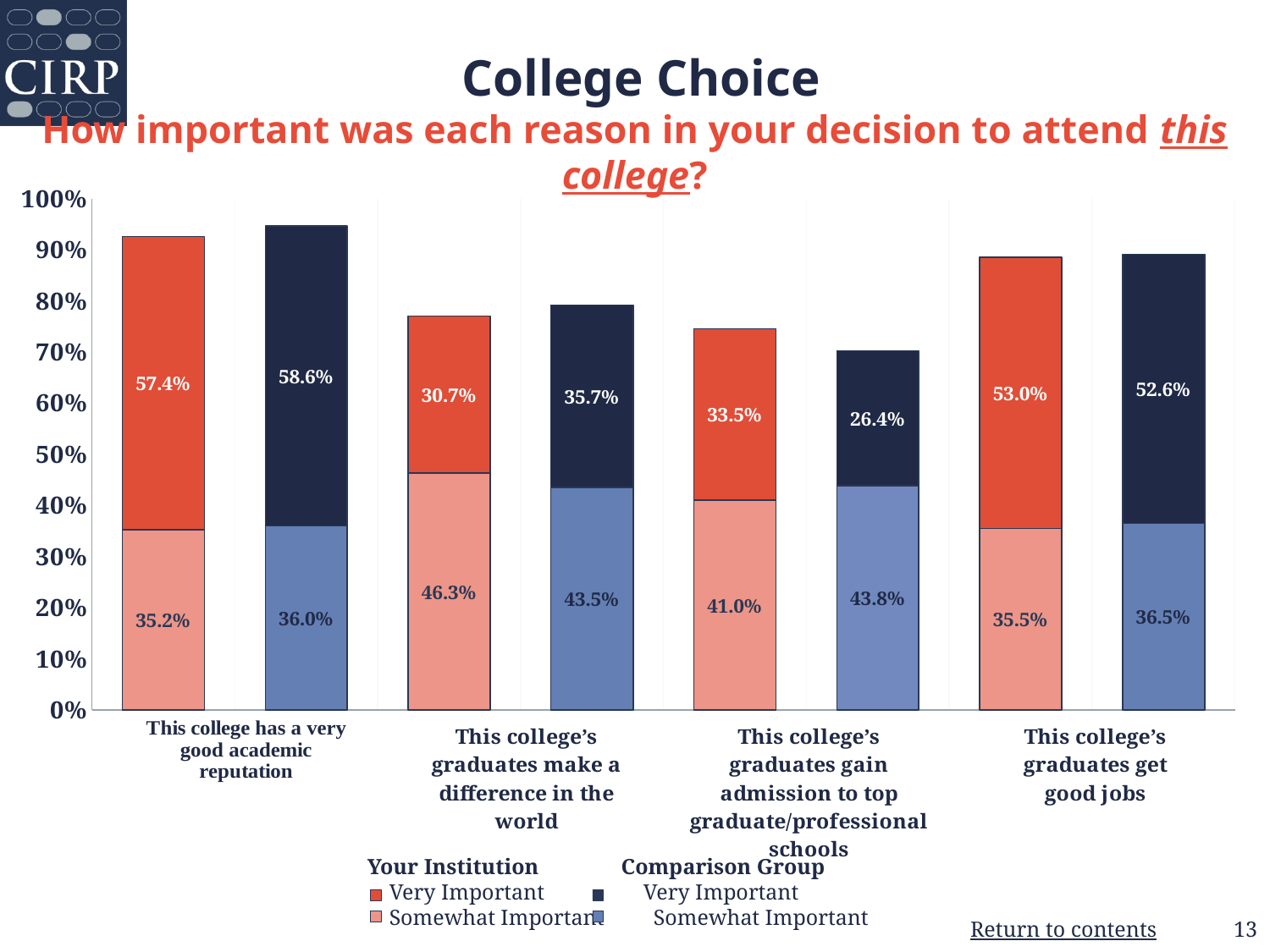
Which reason has the lowest Very Important percentage for the Comparison Group? This college's graduates gain admission to top graduate/professional schools What percentage of the Comparison Group rated "This college's graduates gain admission to top graduate/professional schools" as Very Important? 26.4% How many series does the legend list? 4 What percentage of Your Institution respondents rated "This college has a very good academic reputation" as Very Important? 57.4% What is the difference between the Comparison Group and Your Institution Very Important percentages for "This college's graduates make a difference in the world"? 5.0% What kind of chart is shown on the slide? Stacked bar chart What percentage of the Comparison Group rated "This college's graduates get good jobs" as Somewhat Important? 36.5% Which reason has the highest Very Important percentage for Your Institution? This college has a very good academic reputation What is the combined Very Important and Somewhat Important total for the Comparison Group on "This college's graduates get good jobs"? 89.1% How many reasons (categories) are shown on the x axis of the chart? 4 For "This college's graduates gain admission to top graduate/professional schools", which is larger: the Very Important percentage for Your Institution or for the Comparison Group? Your Institution What is the combined Very Important and Somewhat Important total for Your Institution on "This college has a very good academic reputation"? 92.6%